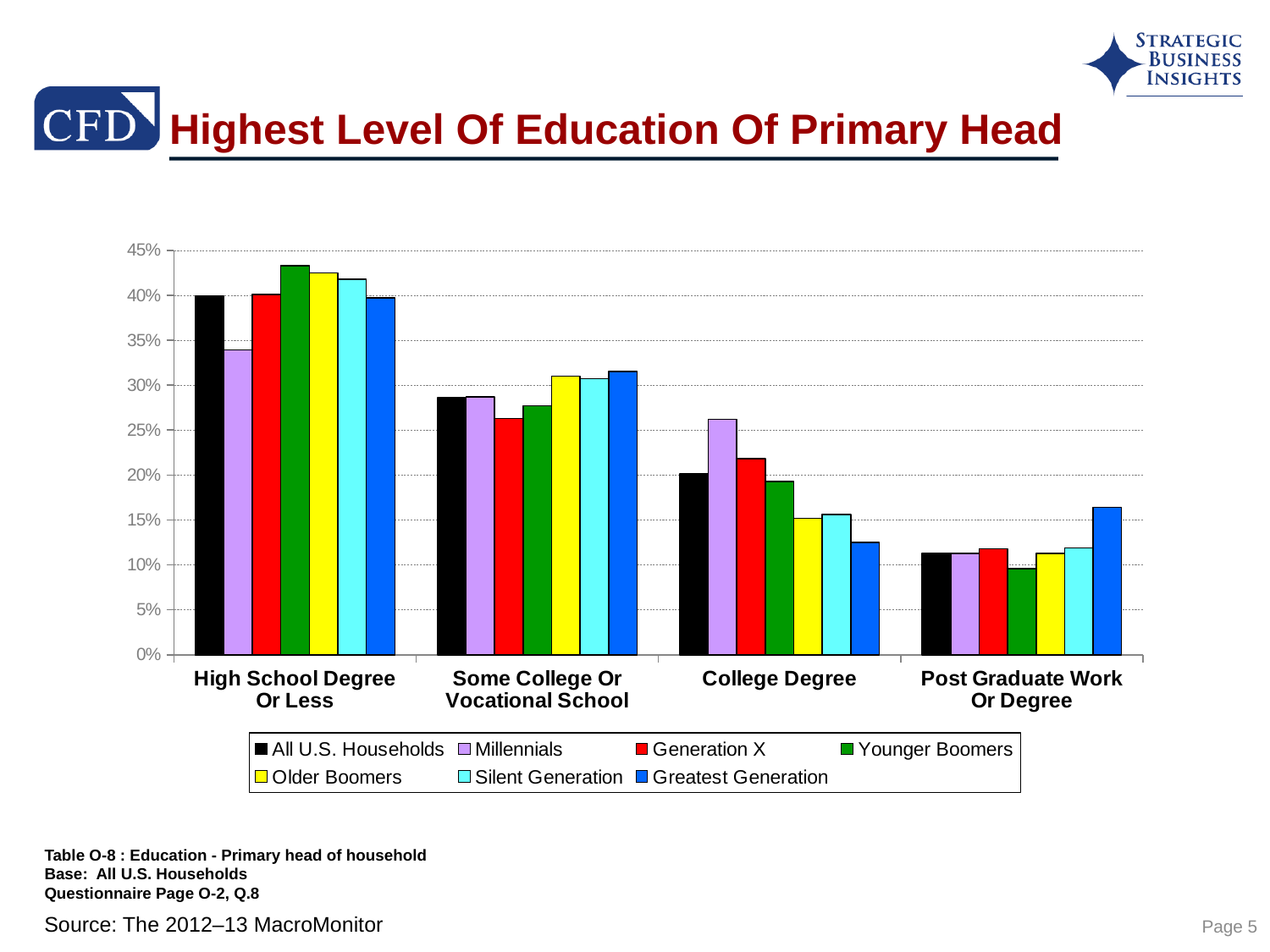
What kind of chart is shown on the slide? bar chart How many series does the legend list? 7 Within the Post Graduate Work Or Degree category, which series has the lowest value? Younger Boomers Is the value for Millennials in the High School Degree Or Less category greater or less than 35%? less How many education-level categories are shown on the x axis? 4 Is the value for Greatest Generation in the College Degree category greater or less than 15%? less Within the Post Graduate Work Or Degree category, which series has the highest value? Greatest Generation Within the College Degree category, which series has the highest value? Millennials Within the High School Degree Or Less category, which series has the lowest value? Millennials Do the values for All U.S. Households rise or fall moving from High School Degree Or Less to Post Graduate Work Or Degree? fall Within the College Degree category, which series has the lowest value? Greatest Generation In the College Degree category, which is larger: Millennials or Older Boomers? Millennials